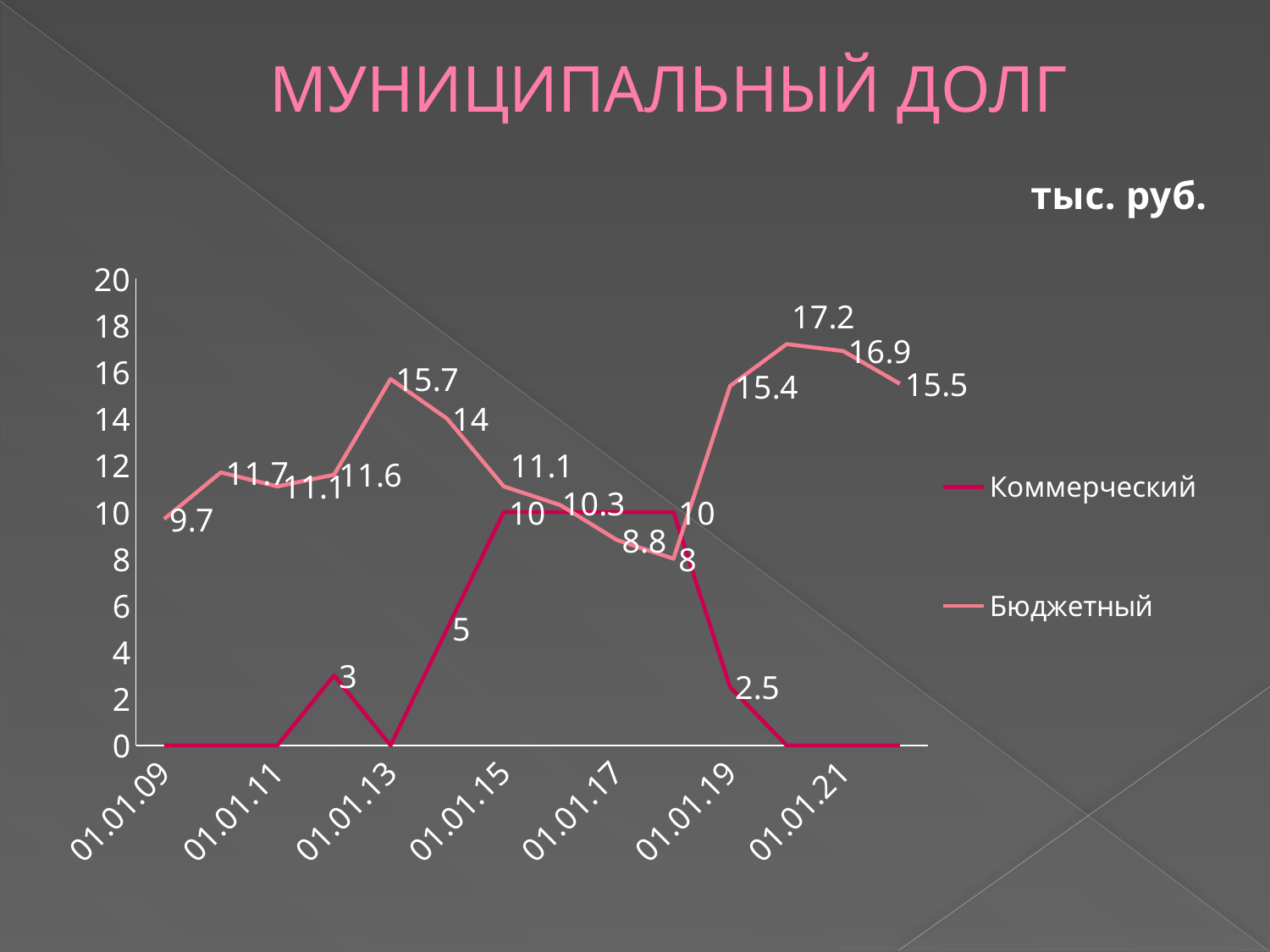
How many series does the legend list? 2 What is the value of the Бюджетный series at 01.01.21? 16.9 Does the Бюджетный series rise or fall between 01.01.13 and 01.01.17? Fall What is the difference between the Бюджетный and Коммерческий values at 01.01.19? 12.9 What is the value of the Бюджетный series at 01.01.09? 9.7 What is the lowest value reached by the Бюджетный series? 8 What is the highest value reached by the Бюджетный series? 17.2 What unit of measurement is stated above the chart? тыс. руб. What is the value of the Бюджетный series at 01.01.13? 15.7 What type of chart is shown on the slide? Line chart What is the value of the Коммерческий series at 01.01.19? 2.5 At 01.01.17, which series has the larger value, Коммерческий or Бюджетный? Коммерческий